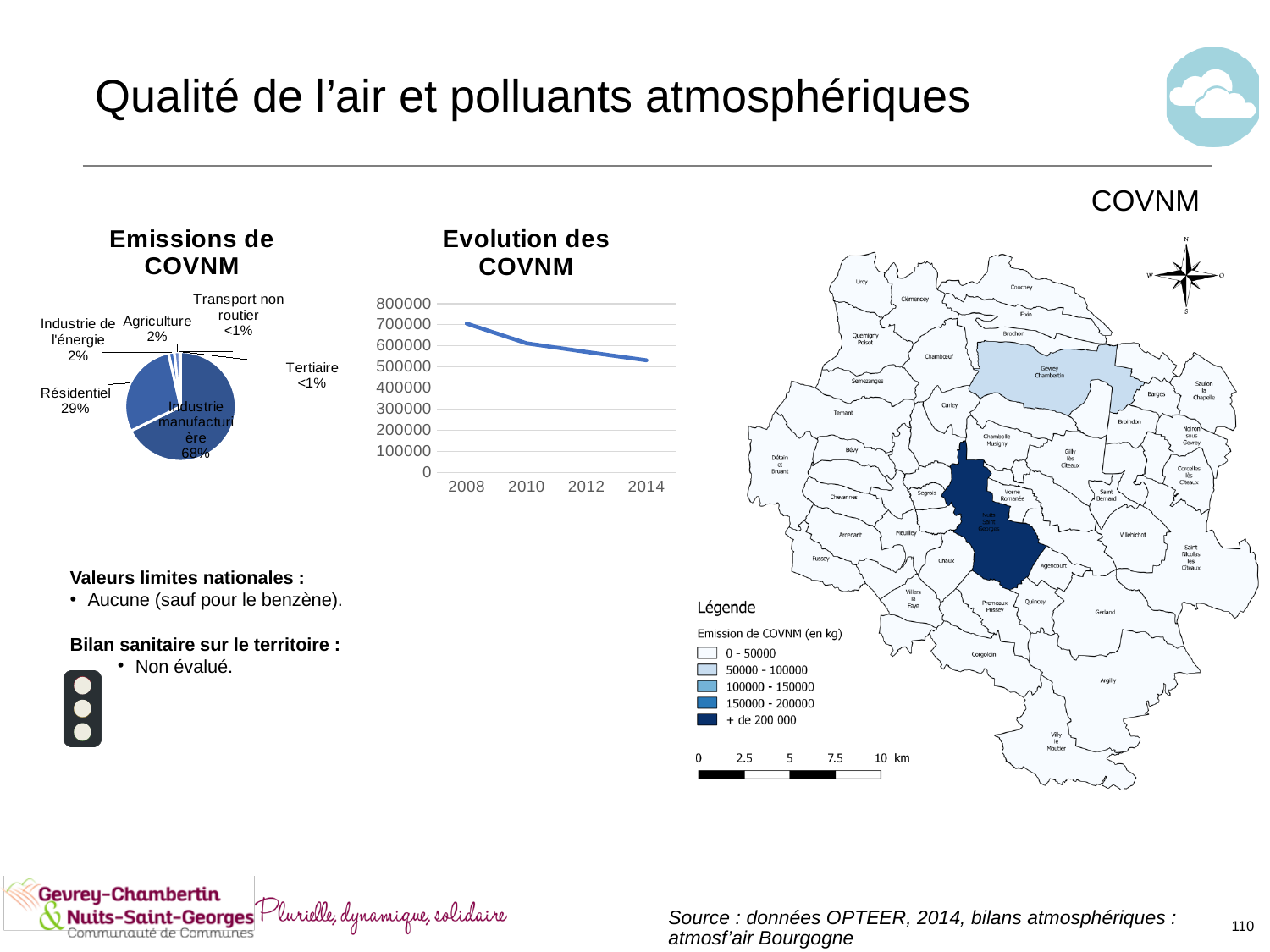
In the 'Emissions de COVNM' pie chart, what share does Industrie manufacturière have? 68% In the 'Emissions de COVNM' pie chart, what is the difference in percentage points between Industrie manufacturière and Résidentiel? 39 percentage points In the 'Evolution des COVNM' chart, do the values rise or fall from 2008 to 2014? Fall What type of chart is 'Evolution des COVNM'? Line chart What type of chart is 'Emissions de COVNM'? Pie chart In the 'Evolution des COVNM' chart, is the value for 2008 greater or less than 600000? greater In the 'Emissions de COVNM' pie chart, what share does Résidentiel have? 29% In the 'Emissions de COVNM' pie chart, what share does Agriculture have? 2% In the 'Evolution des COVNM' chart, is the value for 2014 greater or less than 600000? less In the 'Emissions de COVNM' pie chart, which sector has the largest share? Industrie manufacturière In the 'Emissions de COVNM' pie chart, which is larger, Résidentiel or Industrie de l'énergie? Résidentiel How many sectors are shown in the 'Emissions de COVNM' pie chart? 6